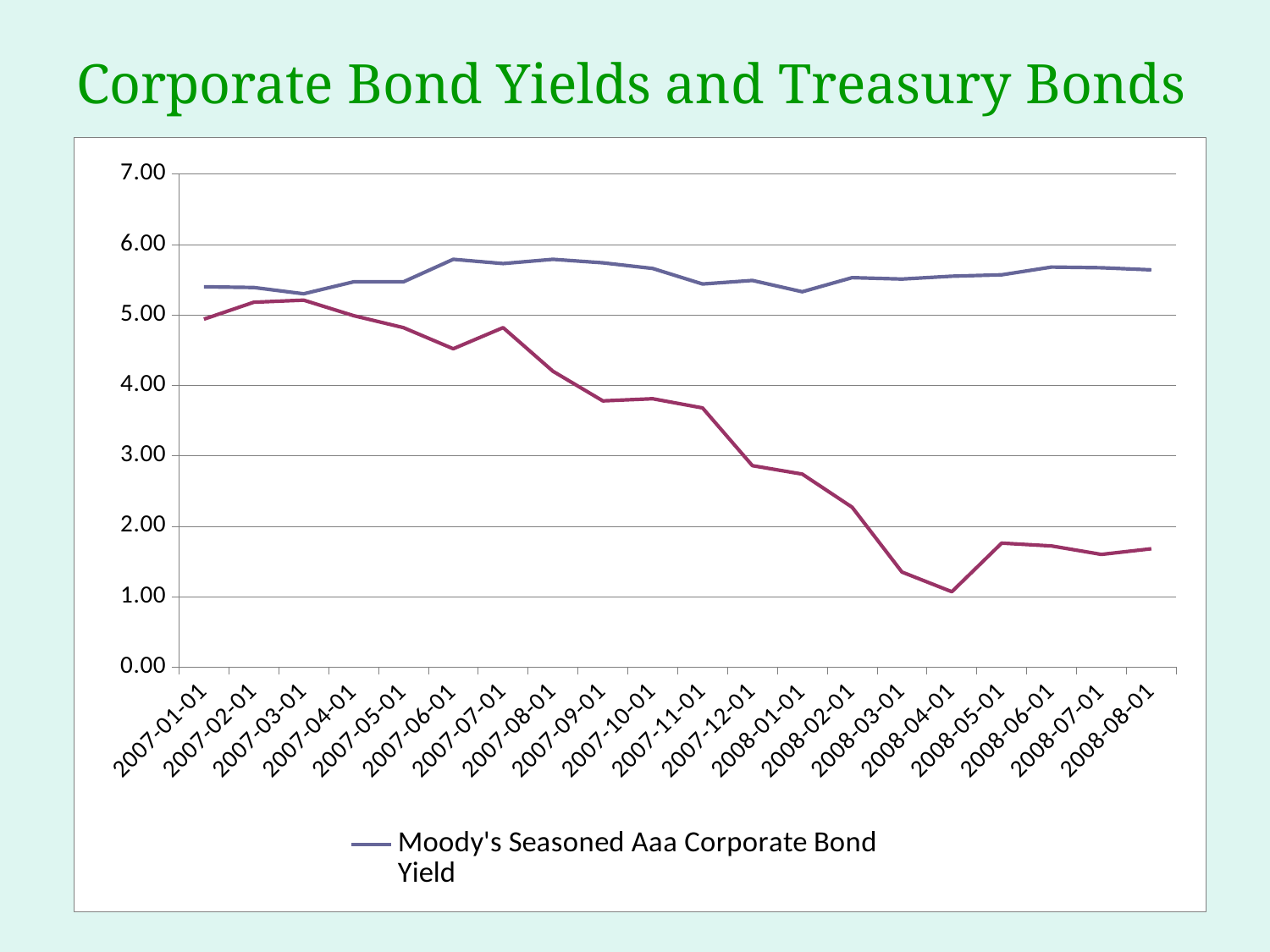
Is the value of the lower (red) line at 2007-06-01 greater or less than 5.00? less How many series does the chart's legend list? 1 How many dates are shown along the x axis of the chart? 20 At 2008-08-01, which line is higher: Moody's Seasoned Aaa Corporate Bond Yield or the lower (red) line? Moody's Seasoned Aaa Corporate Bond Yield What series name appears in the chart's legend? Moody's Seasoned Aaa Corporate Bond Yield Does the lower (red) line generally rise or fall from 2007-01-01 to 2008-08-01? fall Is the value of Moody's Seasoned Aaa Corporate Bond Yield at 2007-06-01 greater or less than 6.00? less Is the value of Moody's Seasoned Aaa Corporate Bond Yield at 2007-01-01 greater or less than 5.00? greater What is the title of the slide containing the chart? Corporate Bond Yields and Treasury Bonds What kind of chart is shown on the slide? line chart